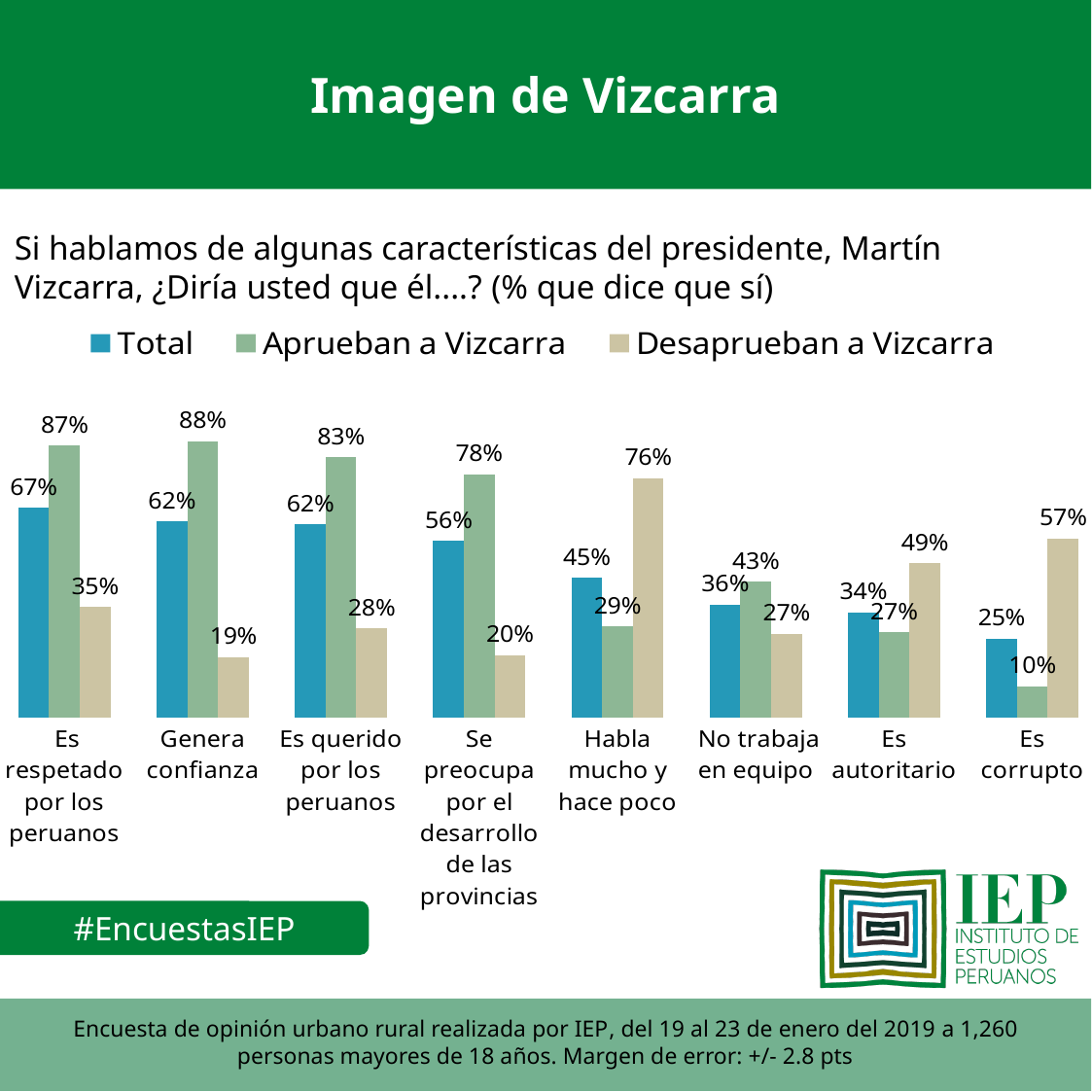
What is the difference between the "Aprueban a Vizcarra" and "Desaprueban a Vizcarra" values for "Se preocupa por el desarrollo de las provincias"? 58 percentage points What is the title of the slide? Imagen de Vizcarra Which category has the lowest "Aprueban a Vizcarra" value? Es corrupto What kind of chart is shown on the slide? Bar chart For "Es autoritario", which is larger: the "Aprueban a Vizcarra" value or the "Desaprueban a Vizcarra" value? Desaprueban a Vizcarra How many characteristics (categories) are shown on the x axis? 8 How many series does the legend list? 3 Which category has the highest "Desaprueban a Vizcarra" value? Habla mucho y hace poco What is the Total value for "Habla mucho y hace poco"? 45% What is the "Desaprueban a Vizcarra" value for "Es corrupto"? 57% What is the Total value for "Es respetado por los peruanos"? 67% What is the "Aprueban a Vizcarra" value for "Genera confianza"? 88%